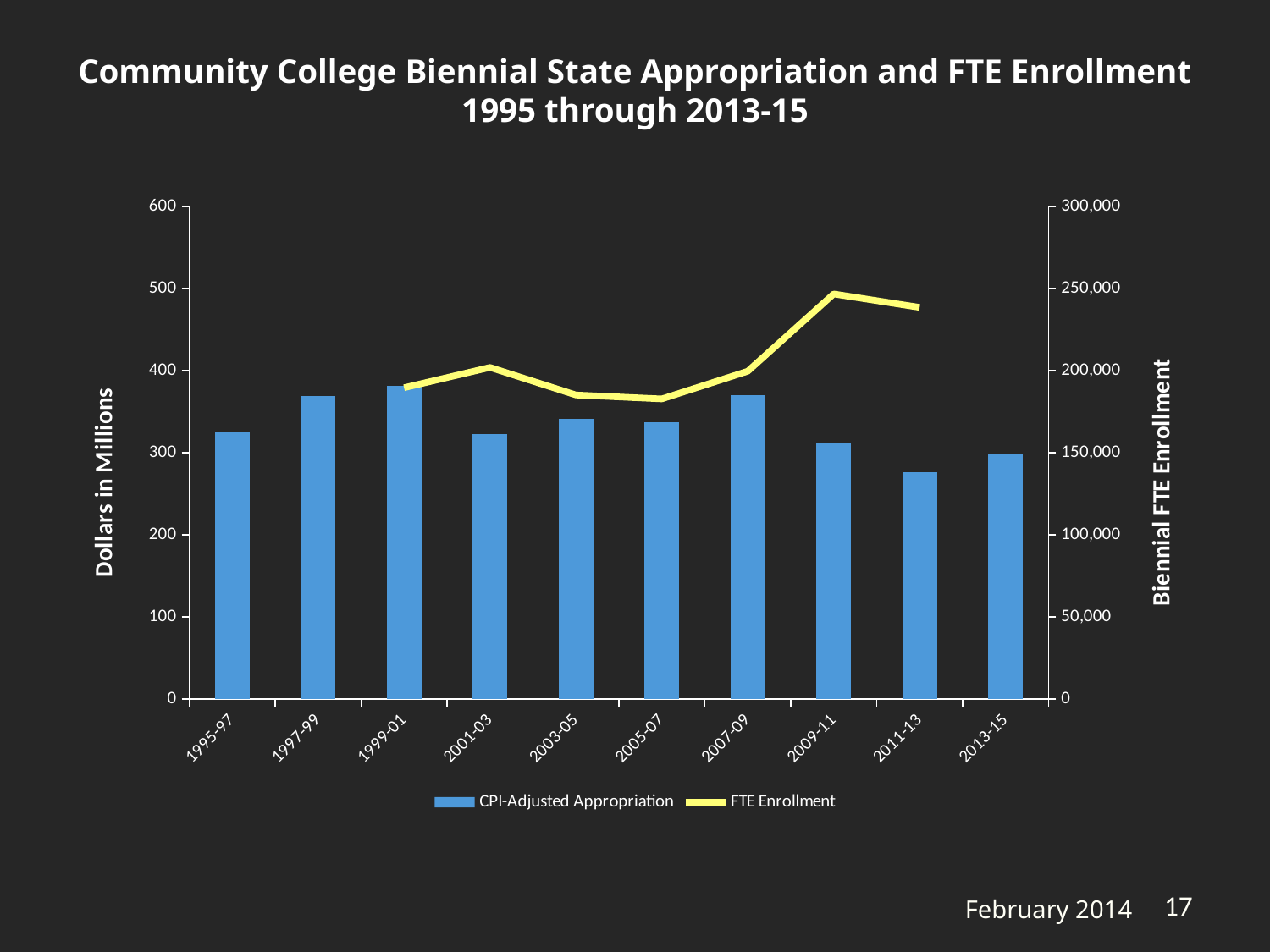
Does the FTE Enrollment line rise or fall from 2005-07 to 2009-11? rise What is the title of the left vertical axis? Dollars in Millions Is the FTE Enrollment for 2009-11 greater or less than 200,000? greater How many biennium categories are shown on the x axis? 10 Which has the larger CPI-Adjusted Appropriation, 1997-99 or 2001-03? 1997-99 In which biennium does the FTE Enrollment line reach its highest point? 2009-11 Is the CPI-Adjusted Appropriation for 1995-97 greater or less than 300 million dollars? greater Which biennium has the lowest CPI-Adjusted Appropriation bar? 2011-13 Is the FTE Enrollment for 2005-07 greater or less than 200,000? less What kind of chart is used for the CPI-Adjusted Appropriation series? Bar chart How many series does the legend list? 2